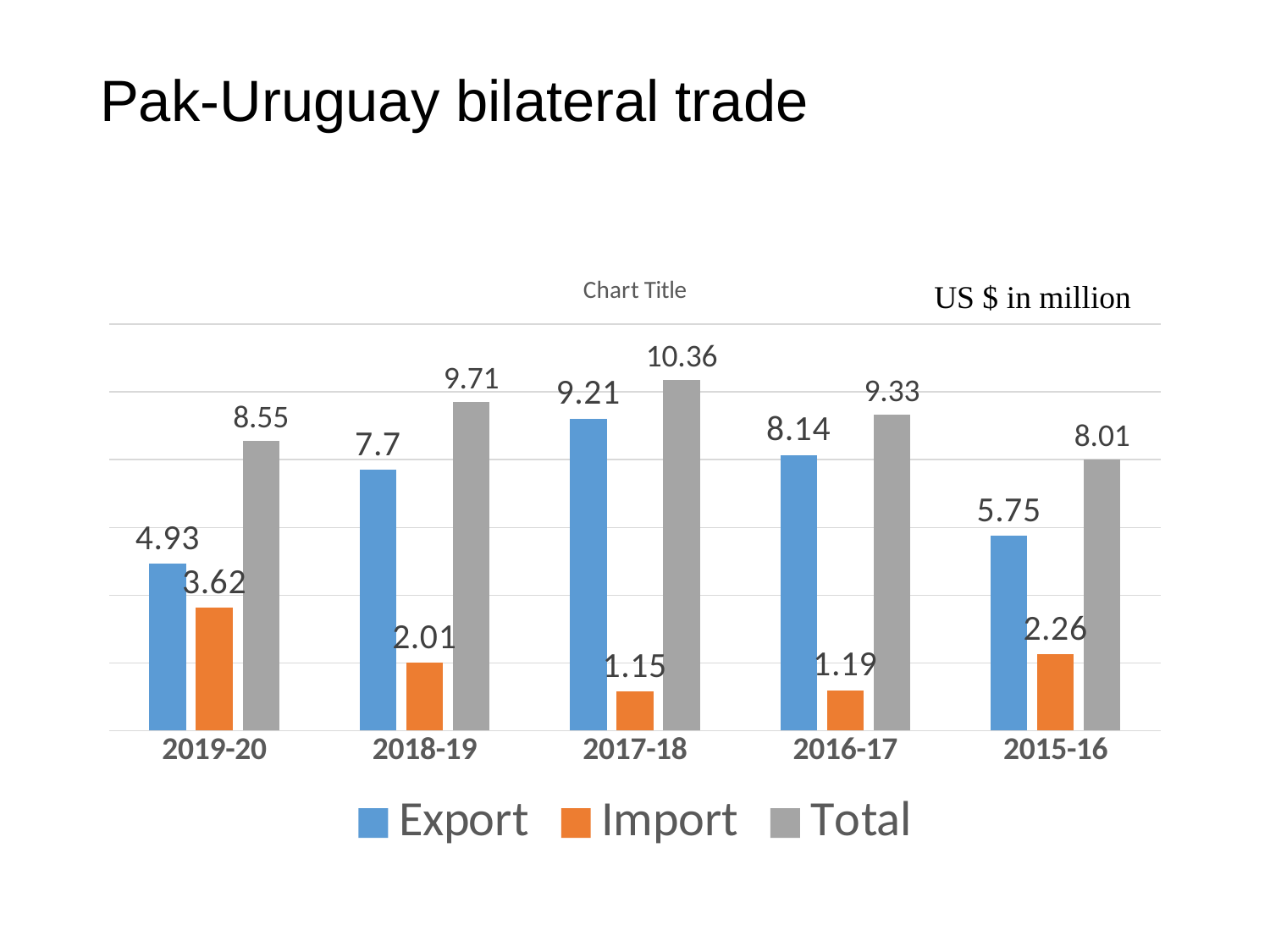
Which year has the lowest Export value? 2019-20 Which year has the highest Total value? 2017-18 What is the Import value for 2019-20? 3.62 How many series does the legend list? 3 How many years are shown on the x axis? 5 What is the Total value for 2015-16? 8.01 Which year has the highest Import value? 2019-20 What kind of chart is shown on the slide? Bar chart What unit is stated for the values in the chart? US $ in million What is the difference between the Export and Import values for 2018-19? 5.69 What is the Export value for 2017-18? 9.21 Which is larger, the Import value for 2016-17 or the Import value for 2015-16? 2015-16